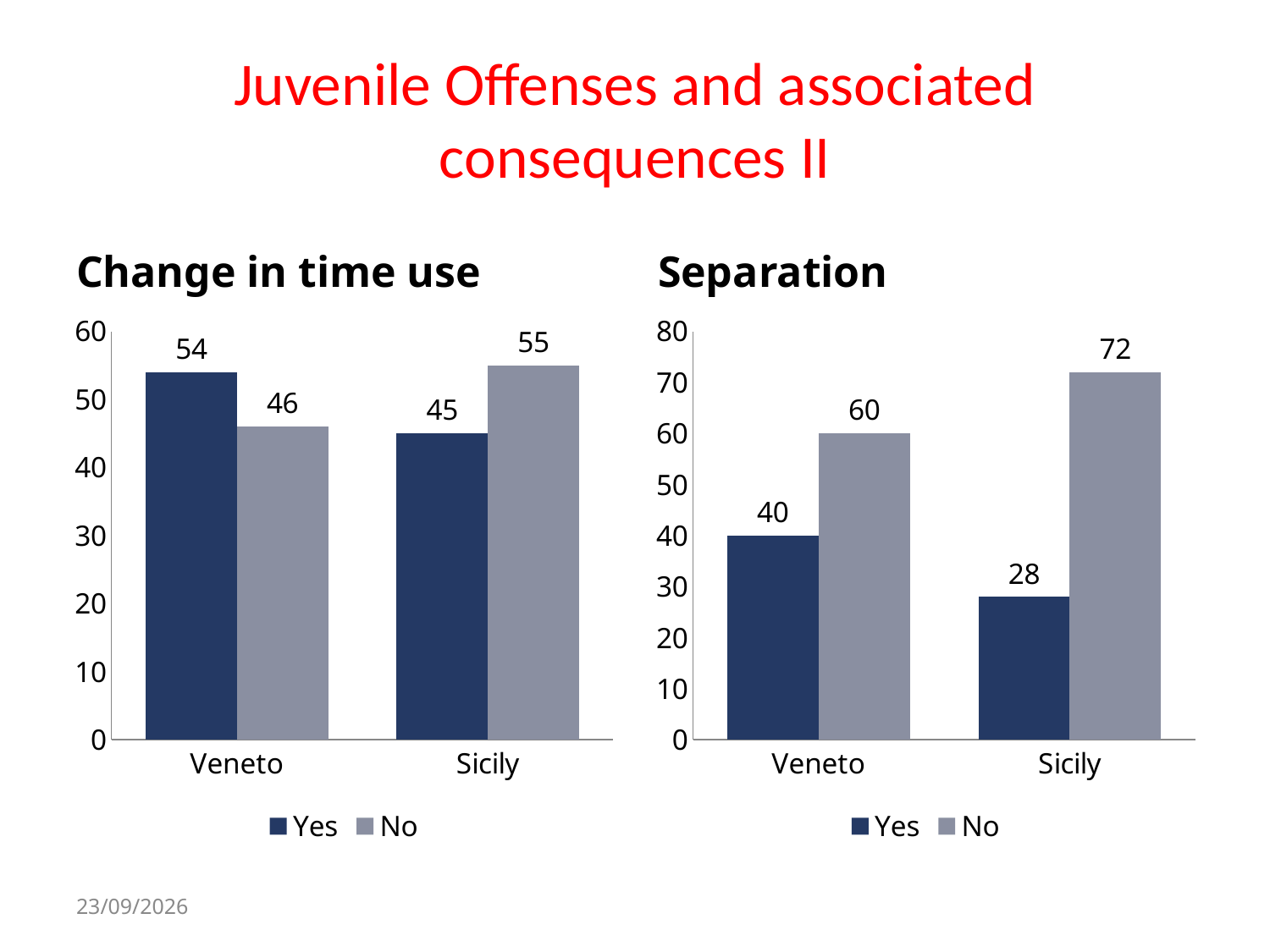
In the 'Separation' chart, which bar is the highest? No, Sicily In the 'Separation' chart, what is the value for Yes in Sicily? 28 In the 'Separation' chart, which bar is the lowest? Yes, Sicily In the 'Change in time use' chart, what is the value for Yes in Veneto? 54 What kind of chart is the 'Change in time use' chart? Bar chart In the 'Change in time use' chart, which is larger for Sicily, Yes or No? No In the 'Change in time use' chart, what is the difference between Yes and No for Veneto? 8 In the 'Separation' chart, what is the value for No in Veneto? 60 In the 'Separation' chart, what is the difference between No and Yes for Sicily? 44 In the 'Change in time use' chart, what is the value for No in Sicily? 55 How many categories are shown on the x axis of the 'Separation' chart? 2 How many series does the legend of the 'Separation' chart list? 2